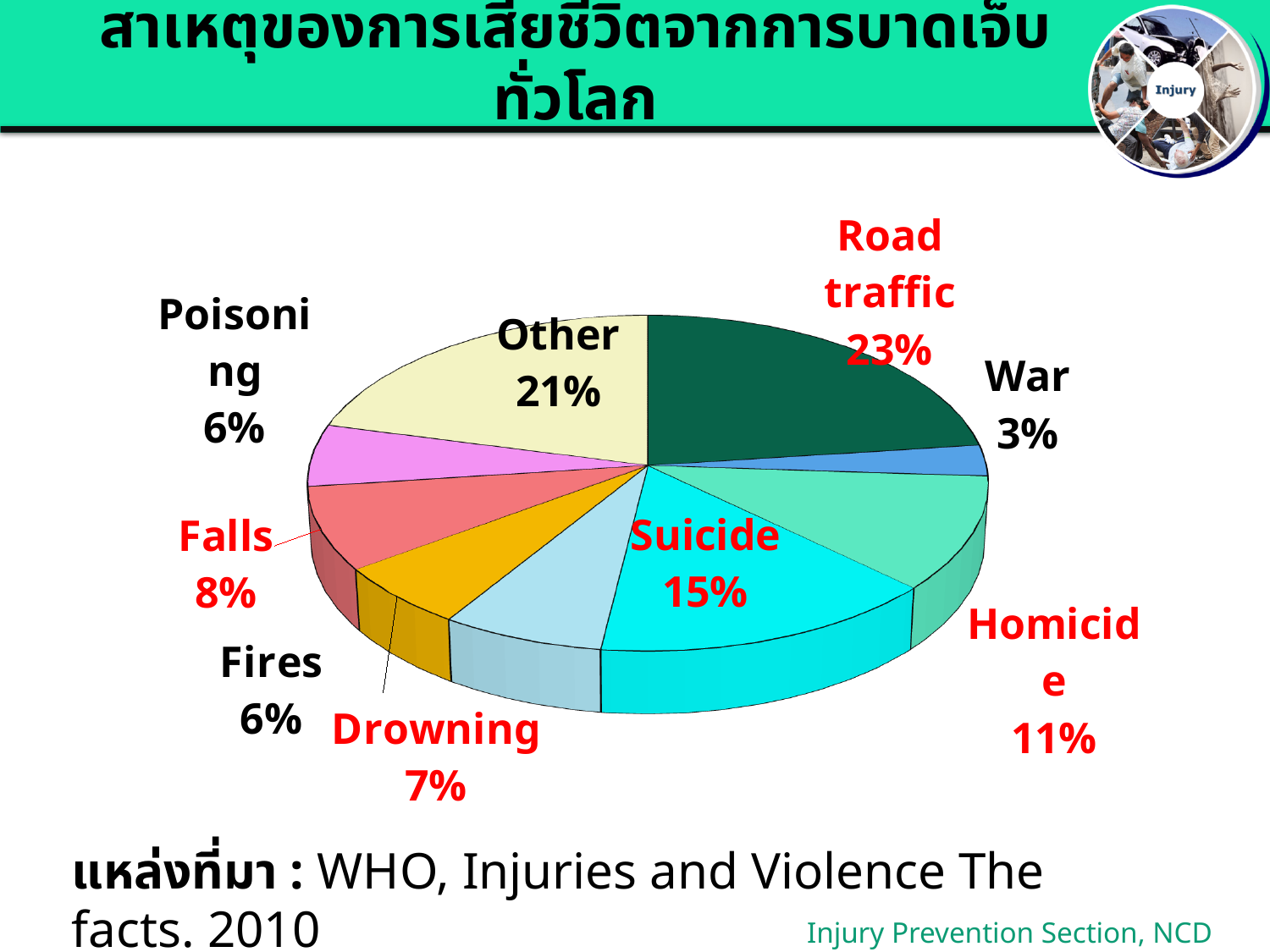
What kind of chart is shown on the slide? pie chart How many categories are shown in the pie chart? 9 What is the difference in percentage points between Road traffic and Other? 2 What share of the pie is Drowning? 7% What is the difference in percentage points between Suicide and Homicide? 4 Which category has the smallest share of the pie? War What share of the pie is Suicide? 15% Which is larger, the share for Falls or the share for Fires? Falls What share of the pie is Homicide? 11% What share of the pie is Road traffic? 23% Which two categories both have a share of 6%? Poisoning and Fires Which category has the largest share of the pie? Road traffic